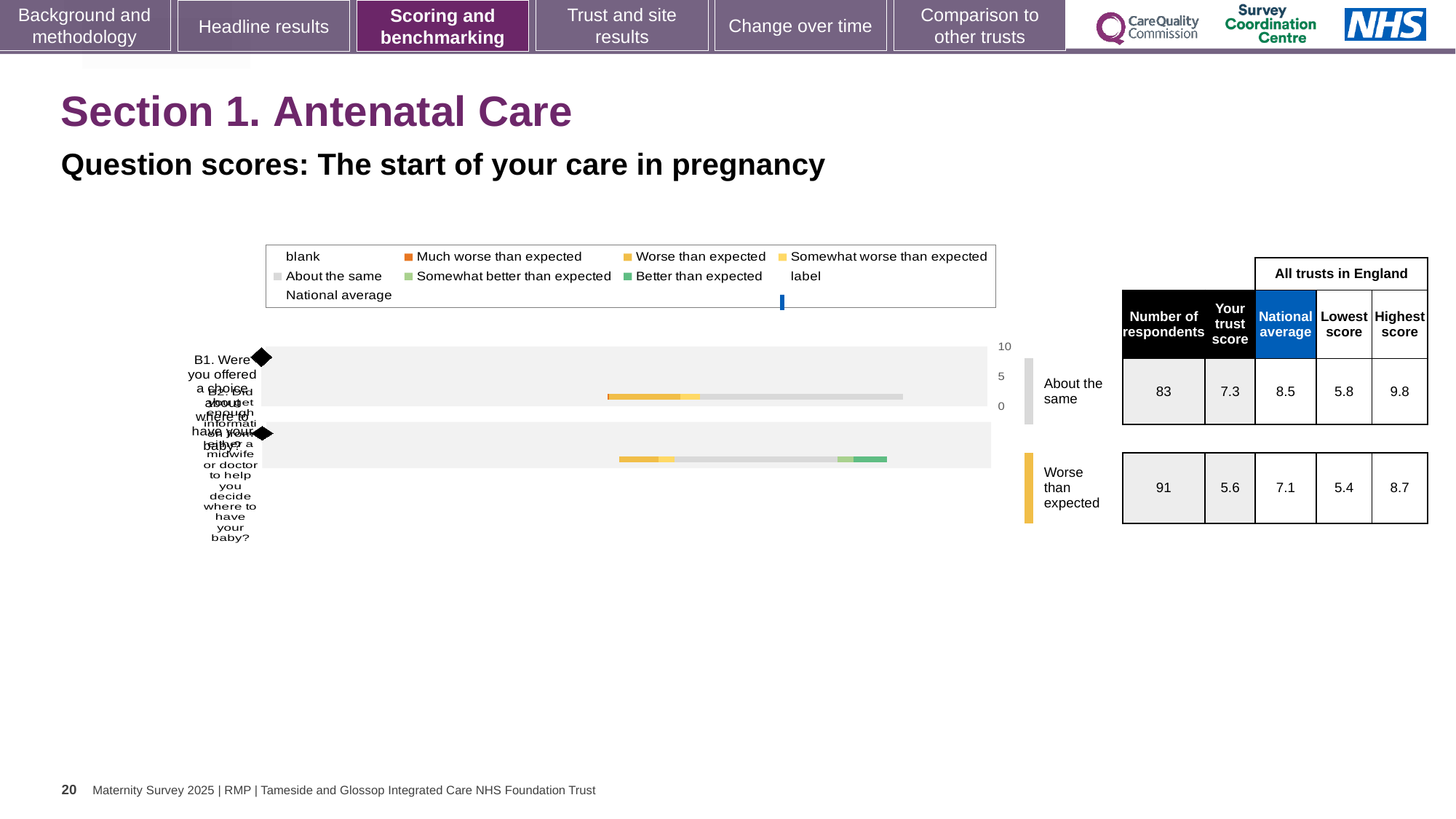
What is the number of respondents for question B1 in the table beside the chart? 83 What is the lowest score across all trusts in England for question B2? 5.4 What benchmark category is shown for question B2? Worse than expected Which question has the higher trust score, B1 or B2? B1 What is the highest score across all trusts in England for question B1? 9.8 Which question has more respondents, B1 or B2? B2 What kind of chart is shown on the slide? bar chart What is the difference between the national average and the trust score for question B2? 1.5 What is the trust score for question B1 (Were you offered a choice about where to have your baby?)? 7.3 What is the national average for question B2 in the table beside the chart? 7.1 How many questions (rows) are plotted in the chart? 2 What is the difference between the national average and the trust score for question B1? 1.2